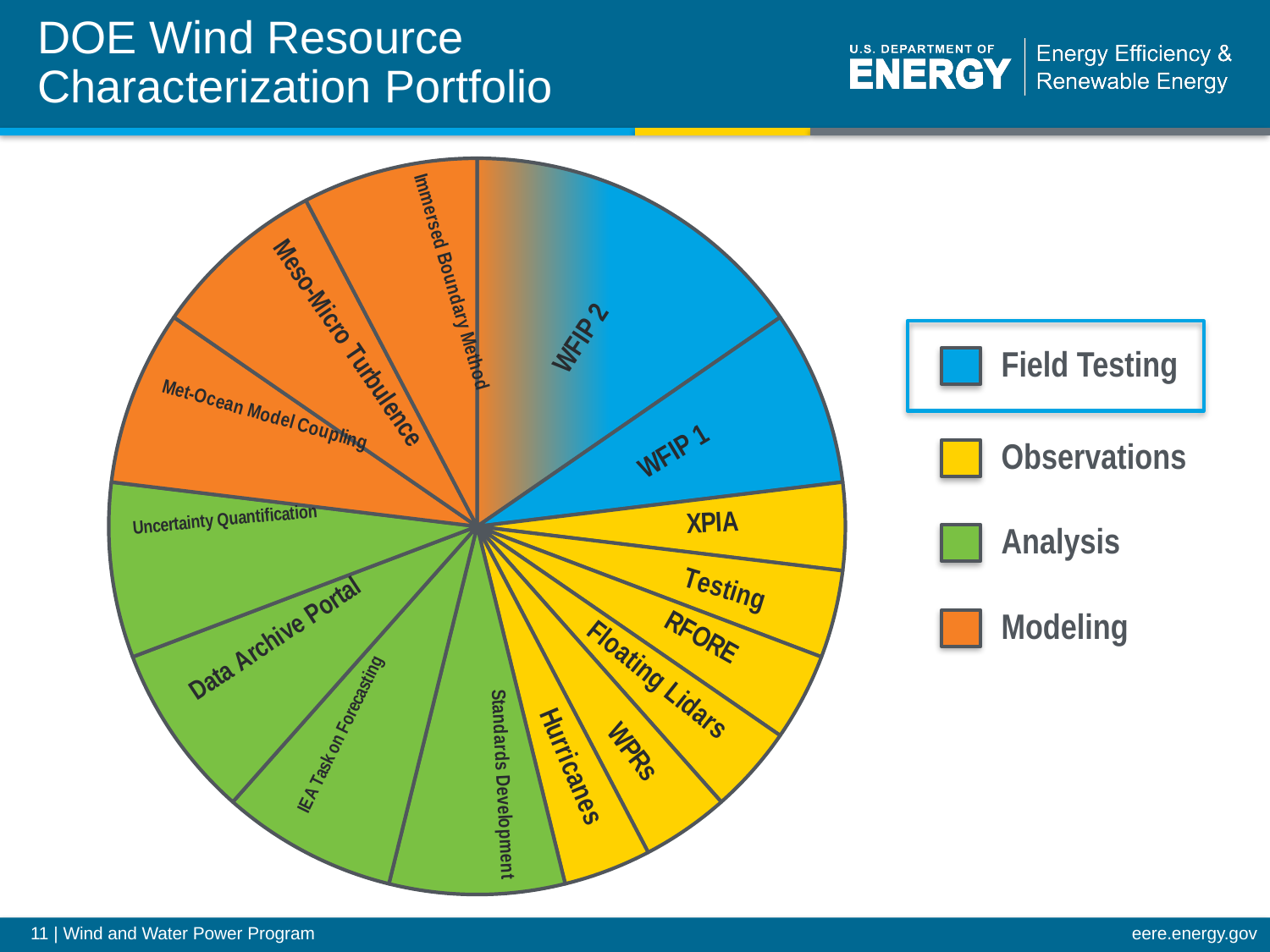
How many slices belong to the Modeling category? 3 What colour represents Analysis in the legend? Green What kind of chart is shown on the slide? Pie chart How many slices belong to the Observations category? 6 Which is larger, the Meso-Micro Turbulence slice or the WPRs slice? Meso-Micro Turbulence How many categories does the legend list? 4 Which is larger, the WFIP 2 slice or the XPIA slice? WFIP 2 How many slices belong to the Field Testing category? 2 Which slice of the pie chart is the largest? WFIP 2 Which legend category does the Hurricanes slice belong to? Observations Which is larger, the Data Archive Portal slice or the Hurricanes slice? Data Archive Portal